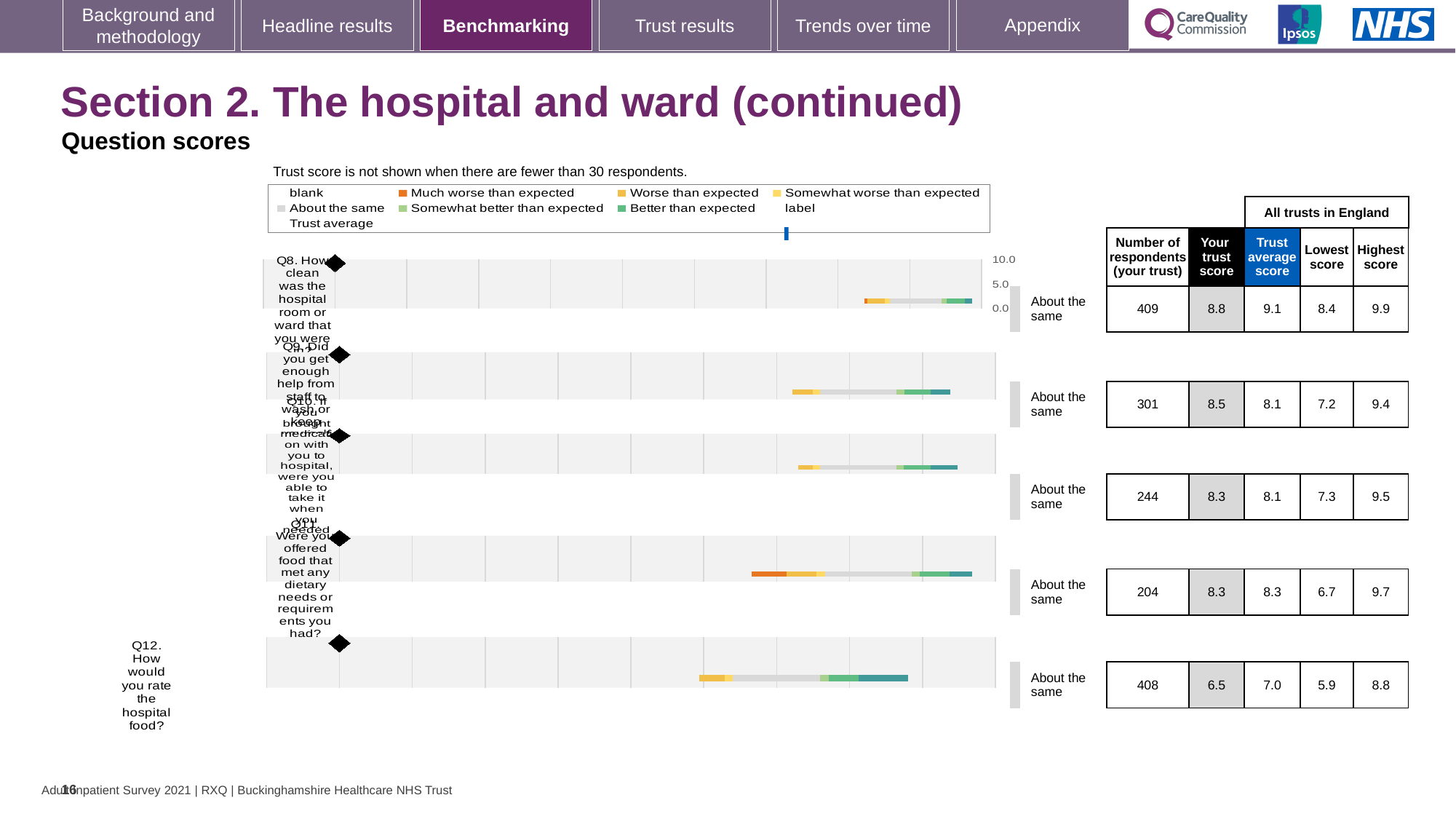
For Q9, which is larger: 'Your trust score' or the 'Trust average score'? Your trust score What benchmark category is shown next to the bar for Q12? About the same What is the 'Trust average score' for Q9 (Did you get enough help from staff to wash or keep yourself clean)? 8.1 What is the 'Highest score' across all trusts in England for Q11 (Were you offered food that met any dietary needs or requirements you had)? 9.7 What is the difference between the 'Highest score' and 'Lowest score' for Q11? 3.0 What kind of chart is used to show the question scores? Bar chart How many respondents from your trust answered Q8 (How clean was the hospital room or ward)? 409 Which question has the highest 'Your trust score'? Q8 What is the 'Your trust score' value for Q12 (How would you rate the hospital food?)? 6.5 How many questions are plotted on the chart? 5 What is the difference between the 'Trust average score' and 'Your trust score' for Q8? 0.3 Which question has the lowest 'Your trust score'? Q12